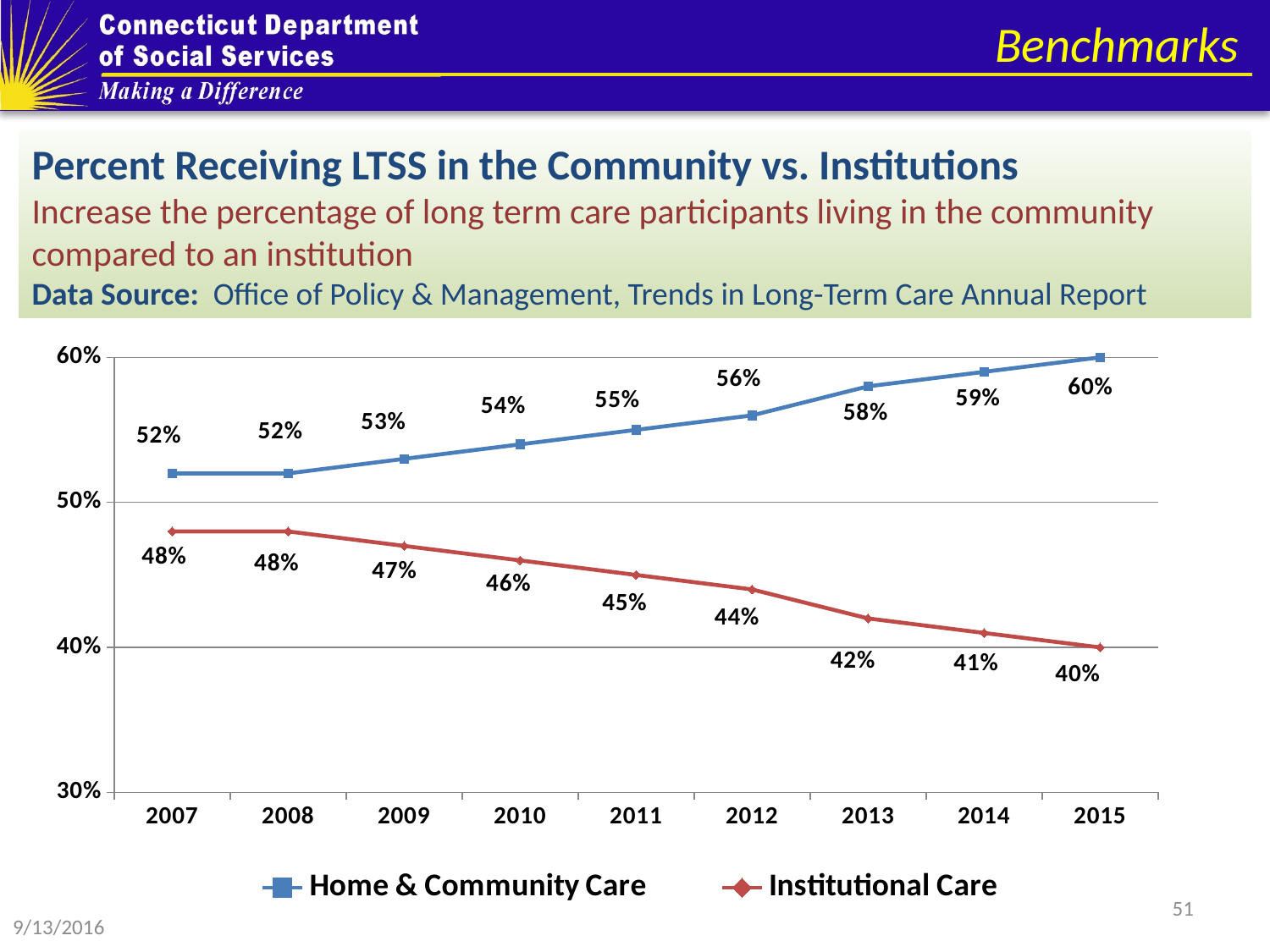
What percentage is shown for Home & Community Care in 2015? 60% How many series does the legend list? 2 Does the Institutional Care series rise or fall from 2007 to 2015? Fall What percentage is shown for Home & Community Care in 2011? 55% What kind of chart is shown on the slide? Line chart What percentage is shown for Institutional Care in 2010? 46% In which year is the Institutional Care value lowest? 2015 In which year is the Home & Community Care value highest? 2015 Which series has the larger value in 2009, Home & Community Care or Institutional Care? Home & Community Care What is the data source named on the slide? Office of Policy & Management, Trends in Long-Term Care Annual Report How many years are shown on the x axis? 9 What is the difference between Home & Community Care and Institutional Care in 2013? 16%